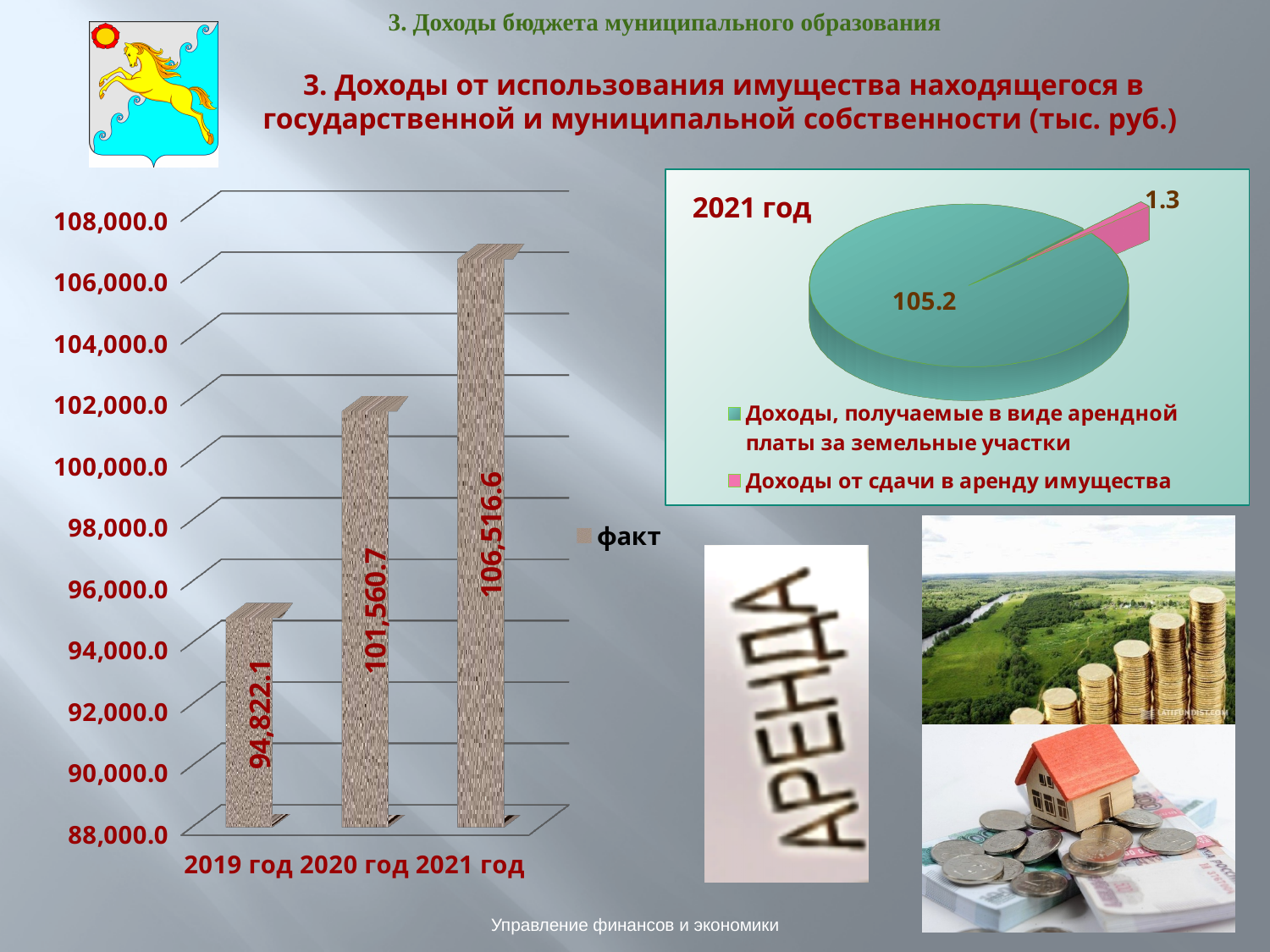
On the bar chart on the left, what is the value for 2020 год? 101,560.7 On the bar chart on the left, what is the value for 2021 год? 106,516.6 On the pie chart titled 2021 год, which category is larger: Доходы, получаемые в виде арендной платы за земельные участки or Доходы от сдачи в аренду имущества? Доходы, получаемые в виде арендной платы за земельные участки On the bar chart on the left, which year has the lowest value? 2019 год On the pie chart titled 2021 год, what is the value for Доходы от сдачи в аренду имущества? 1.3 On the bar chart on the left, what is the difference between the values for 2021 год and 2020 год? 4,955.9 On the bar chart on the left, do the values rise or fall from 2019 год to 2021 год? rise On the bar chart on the left, what is the difference between the values for 2020 год and 2019 год? 6,738.6 On the bar chart on the left, which year has the highest value? 2021 год On the bar chart on the left, what is the name of the series in the legend? факт On the bar chart on the left, what is the value for 2019 год? 94,822.1 On the bar chart on the left, how many years are shown? 3